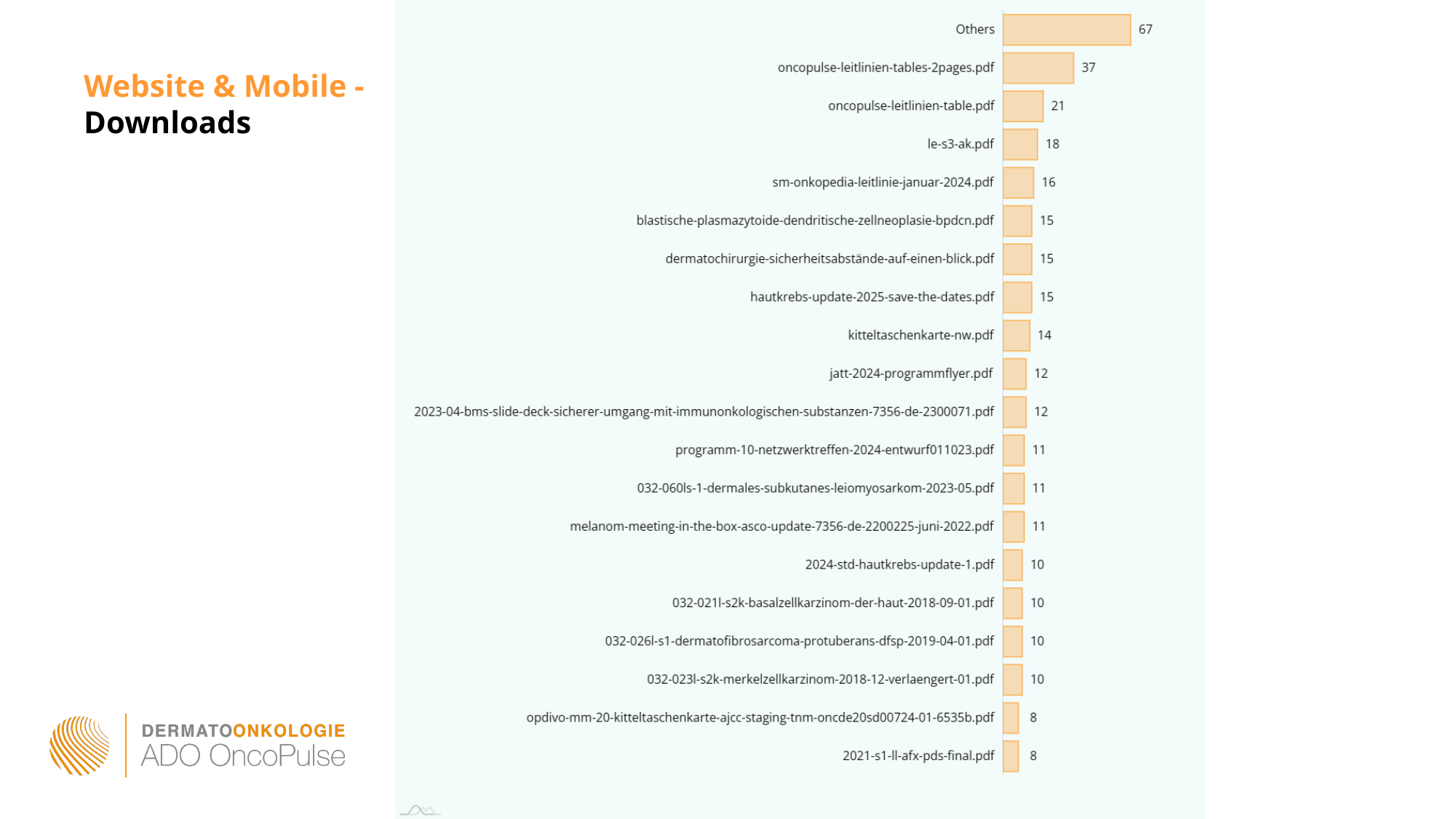
What is the difference between the values for Others and oncopulse-leitlinien-tables-2pages.pdf? 30 What is the value for 2021-s1-ll-afx-pds-final.pdf? 8 Which category has the highest value? Others What kind of chart is shown on the slide? bar chart Which is larger, the value for jatt-2024-programmflyer.pdf or the value for 2024-std-hautkrebs-update-1.pdf? jatt-2024-programmflyer.pdf What is the value for le-s3-ak.pdf? 18 What is the value for kitteltaschenkarte-nw.pdf? 14 What is the title of the slide containing the chart? Website & Mobile - Downloads What is the value for oncopulse-leitlinien-tables-2pages.pdf? 37 What is the value for Others? 67 How many categories are shown in the chart? 20 What is the difference between the values for oncopulse-leitlinien-table.pdf and sm-onkopedia-leitlinie-januar-2024.pdf? 5